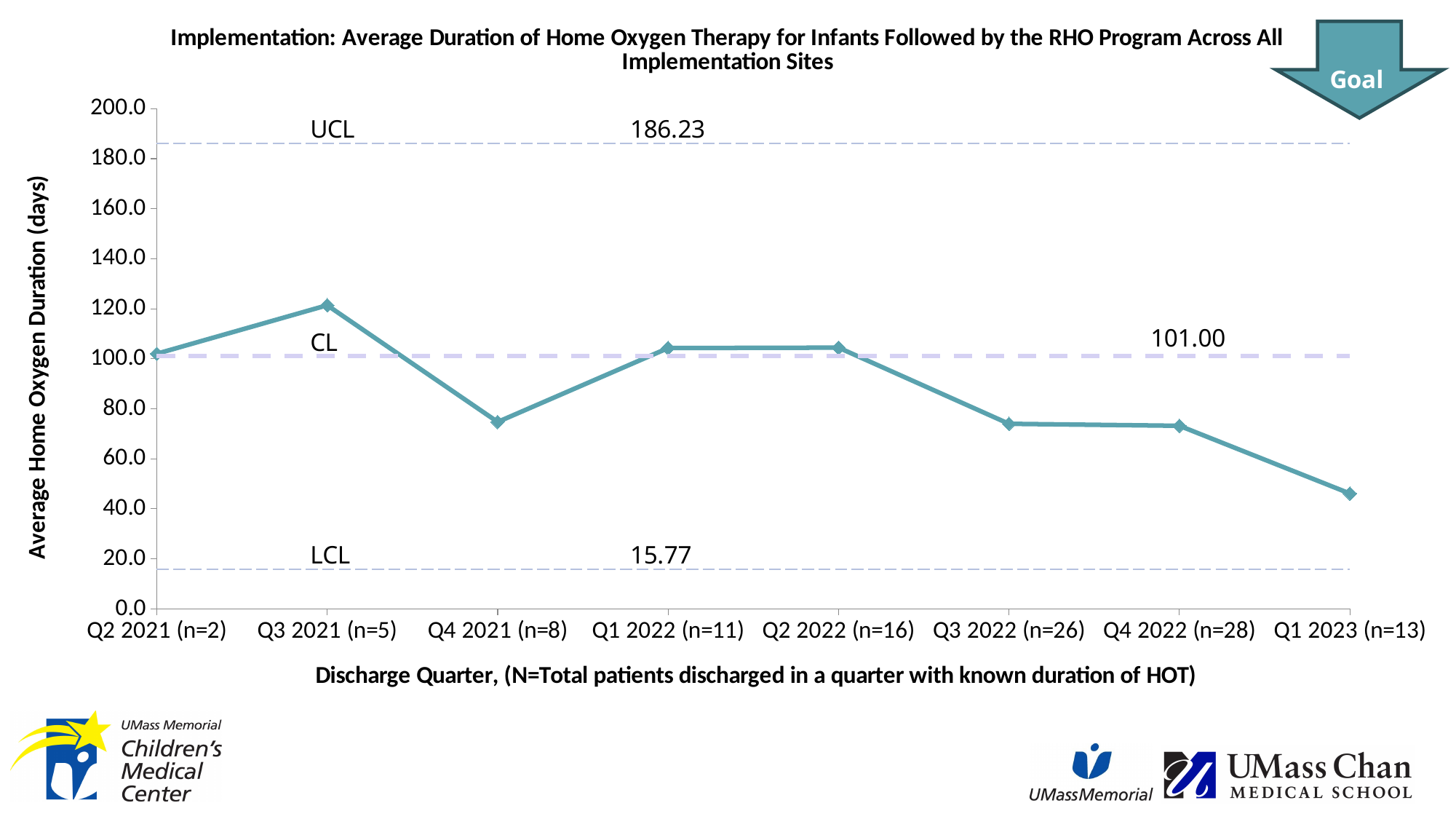
Does the average home oxygen duration rise or fall from Q2 2022 (n=16) to Q1 2023 (n=13)? fall Which discharge quarter has the lowest average home oxygen duration? Q1 2023 (n=13) What is the value of the LCL (lower control limit) shown on the chart? 15.77 What is the value of the UCL (upper control limit) shown on the chart? 186.23 Which discharge quarter has the highest average home oxygen duration? Q3 2021 (n=5) Which has a higher average home oxygen duration, Q3 2021 (n=5) or Q4 2021 (n=8)? Q3 2021 (n=5) Is the average home oxygen duration for Q1 2023 (n=13) greater or less than 60.0 days? less Is the average home oxygen duration for Q3 2021 (n=5) greater or less than 100.0 days? greater How many discharge quarters are plotted on the chart? 8 What type of chart is shown on the slide? line chart What is the value of the CL (center line) shown on the chart? 101.00 Is the average home oxygen duration for Q4 2021 (n=8) greater or less than 80.0 days? less